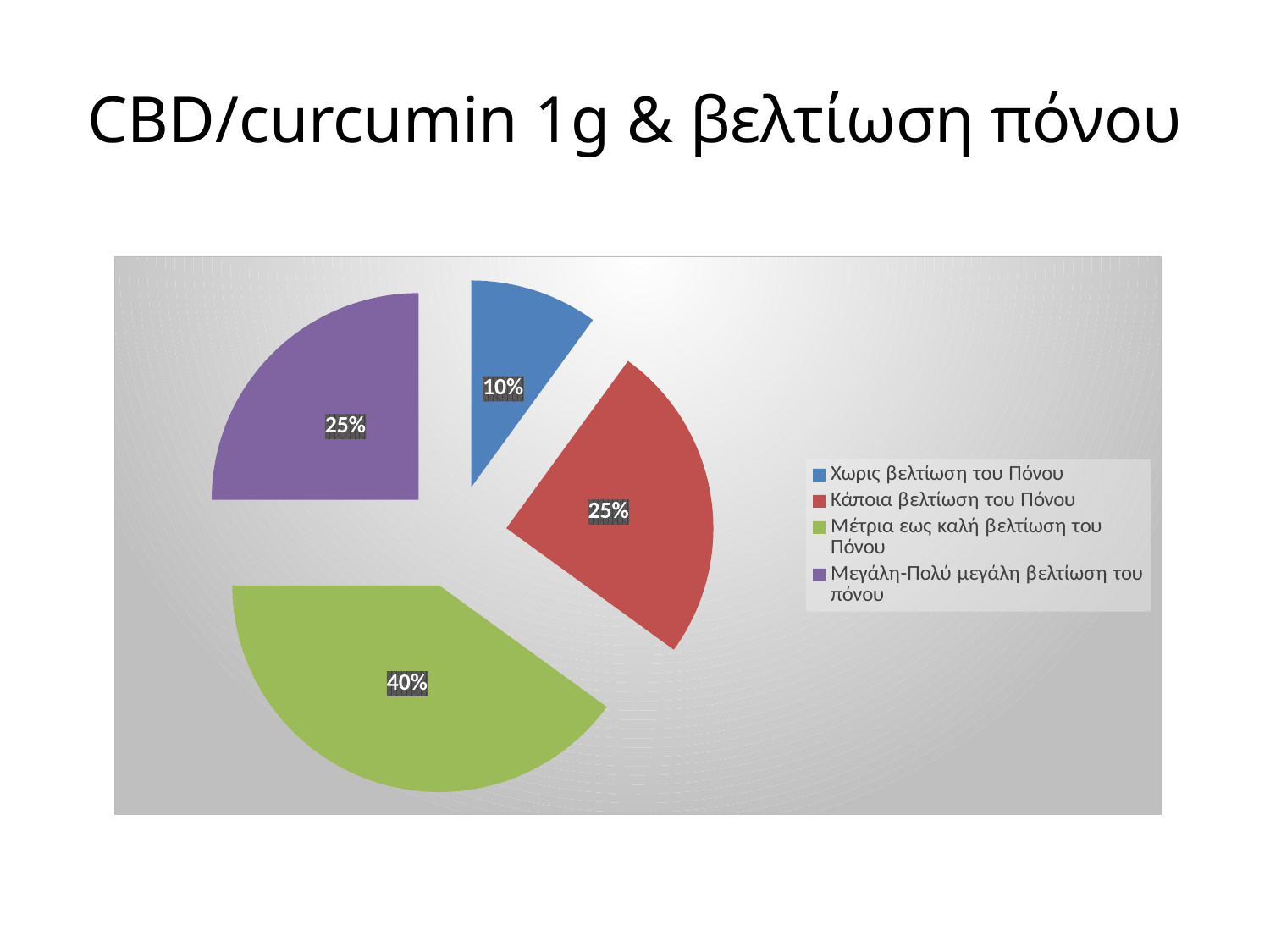
Which category has the smallest slice of the pie? Χωρις βελτίωση του Πόνου How many slices does the pie chart have? 4 What is the difference in percentage points between the "Μέτρια εως καλή βελτίωση του Πόνου" slice and the "Χωρις βελτίωση του Πόνου" slice? 30% What is the title of the slide containing the pie chart? CBD/curcumin 1g & βελτίωση πόνου What share of the pie is labelled for "Μεγάλη-Πολύ μεγάλη βελτίωση του πόνου"? 25% What share of the pie is labelled for "Μέτρια εως καλή βελτίωση του Πόνου"? 40% Which category has the largest slice of the pie? Μέτρια εως καλή βελτίωση του Πόνου Which is larger: the slice for "Κάποια βελτίωση του Πόνου" or the slice for "Χωρις βελτίωση του Πόνου"? Κάποια βελτίωση του Πόνου What share of the pie is labelled for "Χωρις βελτίωση του Πόνου"? 10% What kind of chart is shown on the slide? Pie chart What colour is the slice for "Μεγάλη-Πολύ μεγάλη βελτίωση του πόνου"? Purple